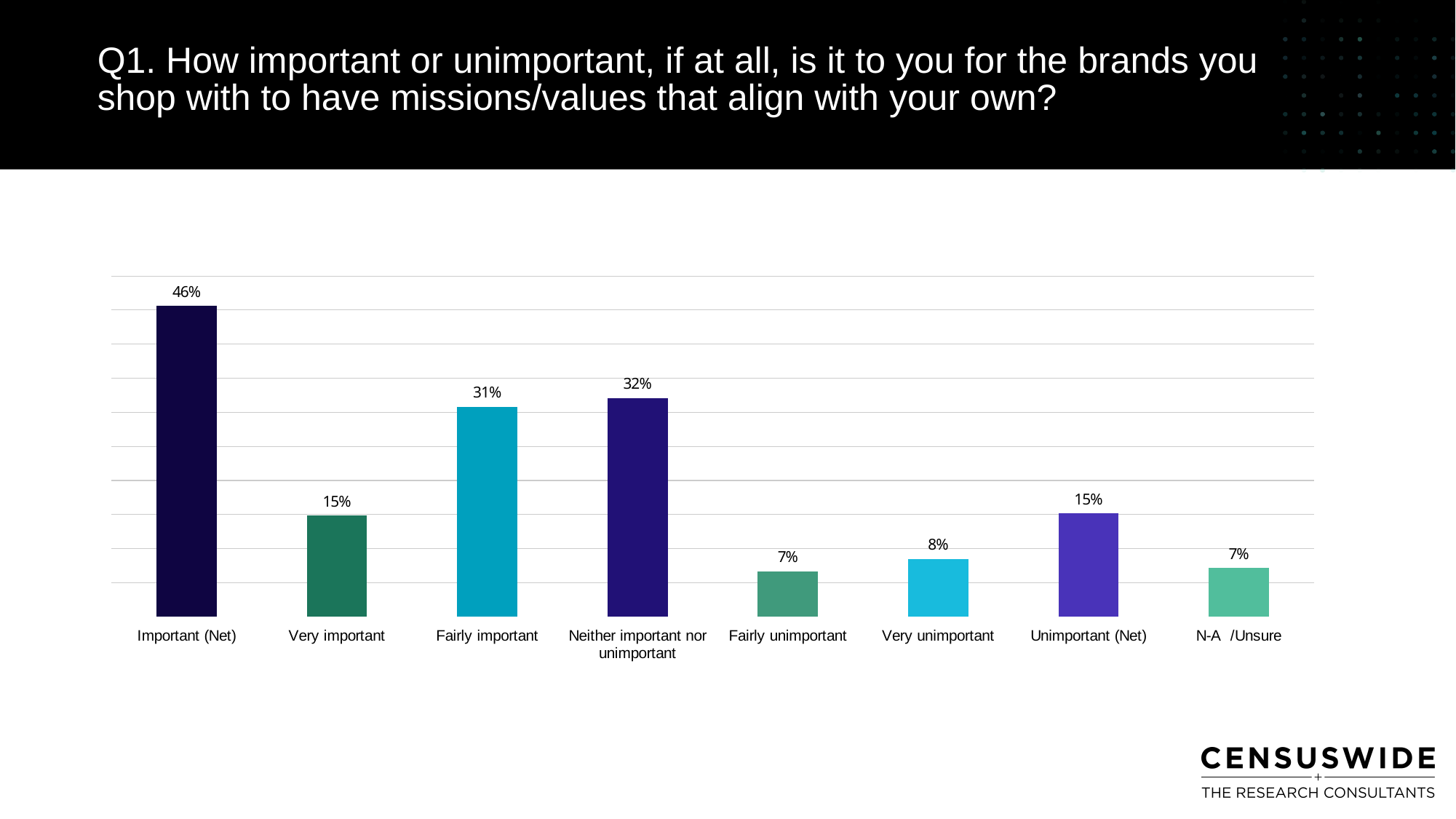
What is the difference between Fairly important and Very important? 16% How many categories are shown on the x axis? 8 Which category has the highest value? Important (Net) What is the value for Neither important nor unimportant? 32% What is the value for Unimportant (Net)? 15% What is the value for Very unimportant? 8% What kind of chart is shown on the slide? Bar chart What is the value for N-A /Unsure? 7% What is the value for Important (Net)? 46% Which is larger, Fairly important or Neither important nor unimportant? Neither important nor unimportant What is the difference between Important (Net) and Unimportant (Net)? 31% Which is larger, Very important or Fairly unimportant? Very important